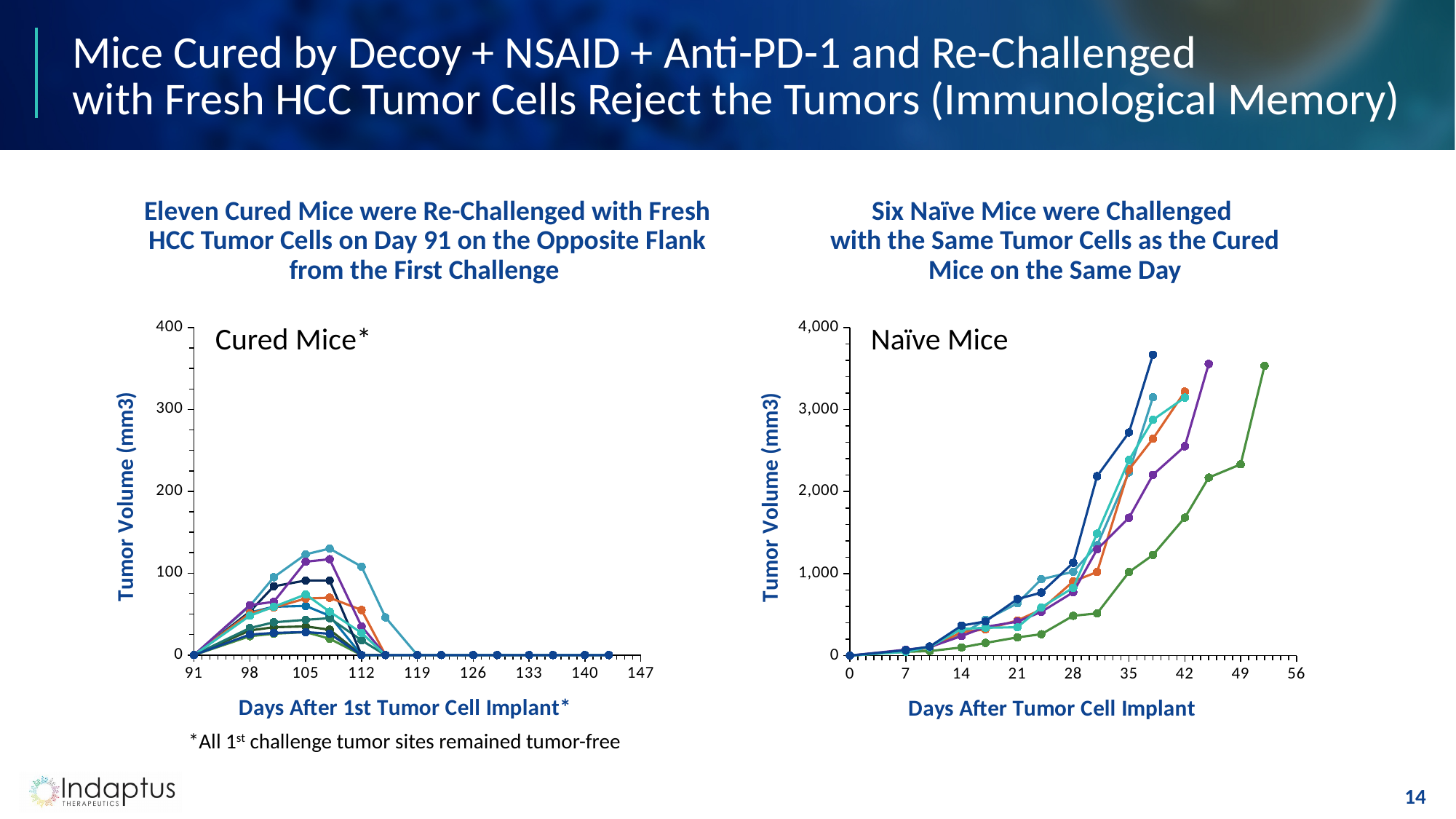
In the Naïve Mice chart, do tumor volumes rise or fall as days increase? rise What is the x-axis label on the Cured Mice chart? Days After 1st Tumor Cell Implant* In the Cured Mice chart, what is the tumor volume of the mice at day 126? 0 What type of chart is the Cured Mice chart on the left? Line chart In the Naïve Mice chart, is the green line's value at day 35 greater or less than 2,000? less In the Cured Mice chart, is the highest tumor volume reached by any line greater or less than 200? less In the Naïve Mice chart, is the highest tumor volume reached by any line greater or less than 3,000? greater What is the y-axis label on the Naïve Mice chart? Tumor Volume (mm3) In the Naïve Mice chart, what is the tumor volume at day 0? 0 How many mice are plotted in the Naïve Mice chart? 6